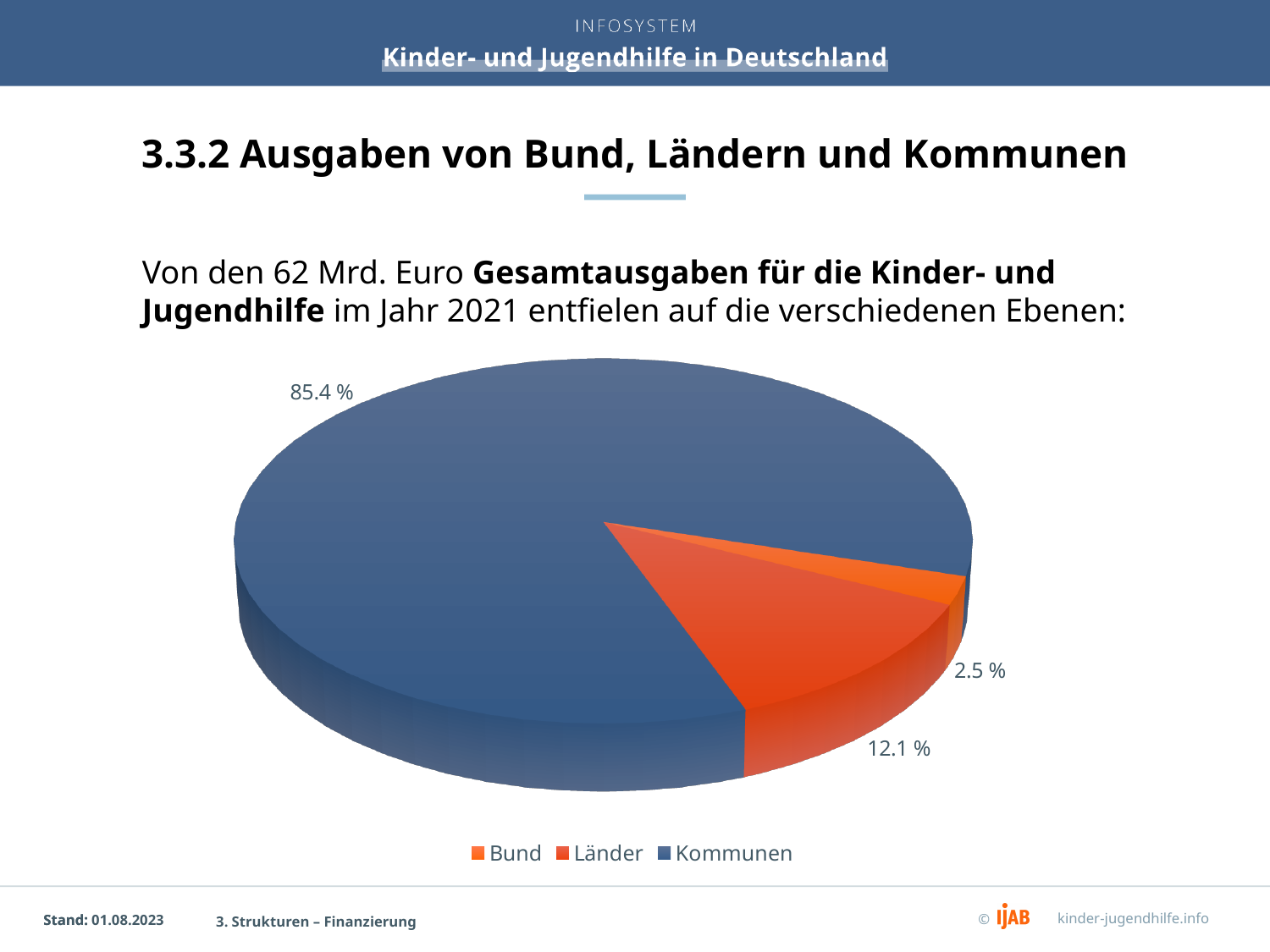
Which colour represents Kommunen in the pie chart? blue Which is larger, the share for Länder or the share for Bund? Länder How many slices does the pie chart have? 3 What share of the expenditure falls to Länder? 12.1 % Which level has the largest share of the expenditure? Kommunen What is the difference in percentage points between the Länder share and the Bund share? 9.6 Which level has the smallest share of the expenditure? Bund What is the difference in percentage points between the Kommunen share and the Länder share? 73.3 What share of the expenditure falls to Kommunen? 85.4 % What kind of chart is shown on the slide? pie chart What share of the expenditure falls to Bund? 2.5 % How many entries does the legend list? 3